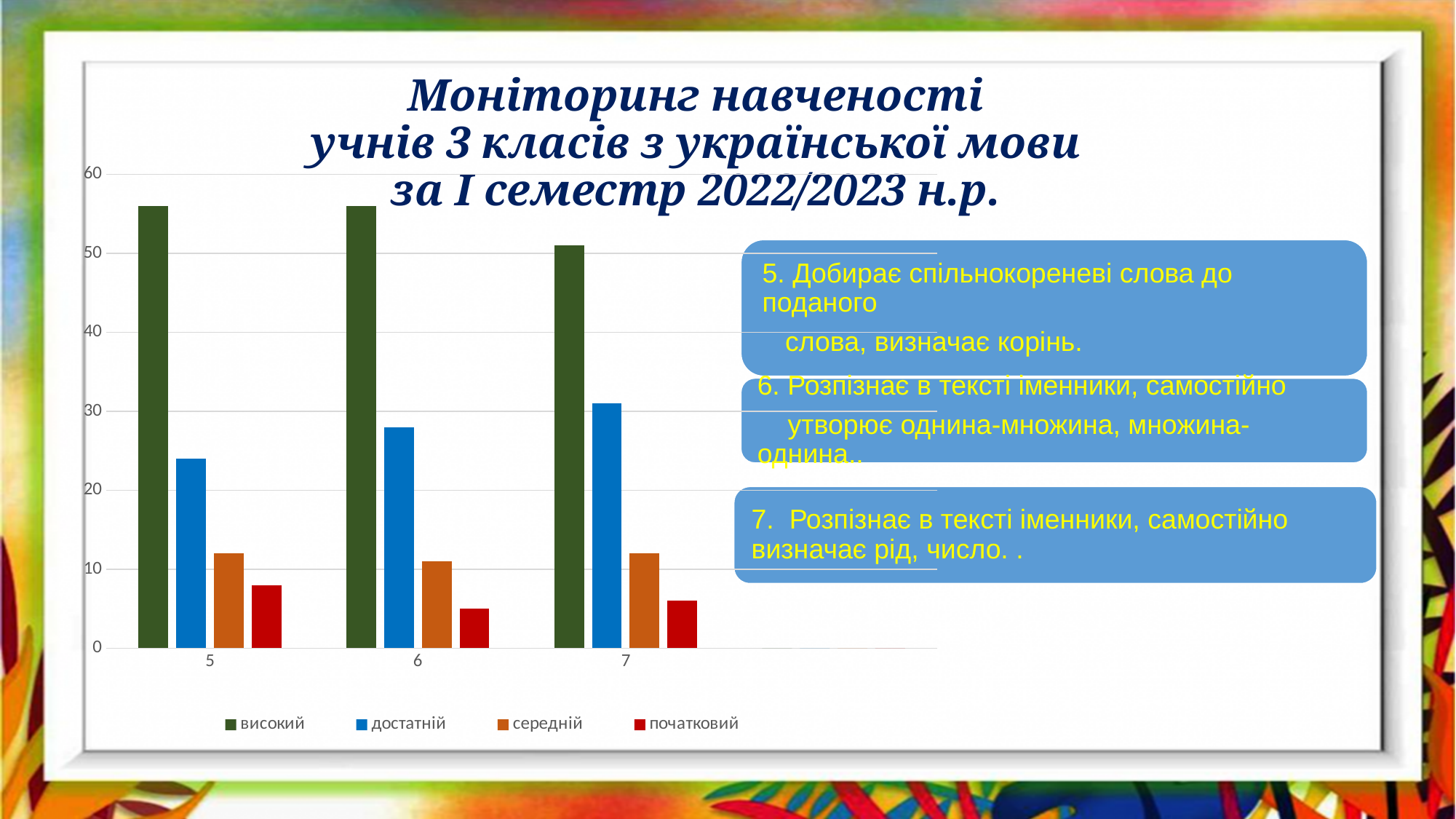
Is the value for достатній in category 5 greater or less than 20? greater Is the value for високий in category 5 greater or less than 50? greater In category 5, which is larger: високий or достатній? високий How many series does the chart legend list? 4 Is the value for високий in category 7 greater or less than 60? less What kind of chart is shown on the slide? bar chart In category 6, which series has the lowest value? початковий Which is larger: достатній in category 7 or достатній in category 5? достатній in category 7 In which category is the достатній series highest? 7 How many categories are shown on the x axis of the chart? 3 Does the достатній series rise or fall from category 5 to category 7? rise